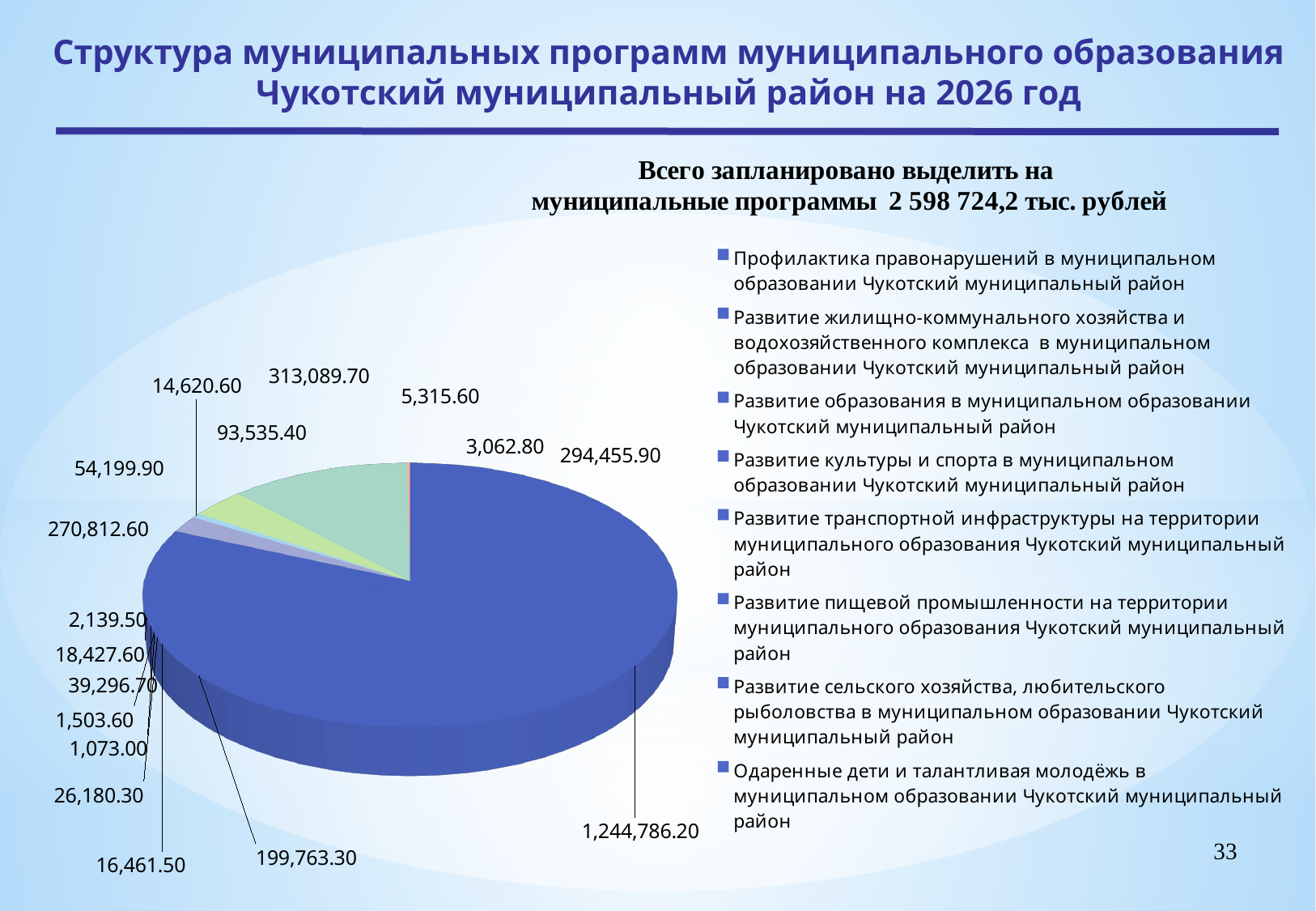
What is the second largest value labelled on the pie chart? 313,089.70 For which year does the slide title say the structure of municipal programmes is shown? 2026 What kind of chart is shown on the slide? pie chart What is the first entry listed in the chart legend? Профилактика правонарушений в муниципальном образовании Чукотский муниципальный район What is the difference between the labelled values 313,089.70 and 294,455.90? 18,633.80 What is the largest value labelled on the pie chart? 1,244,786.20 Which labelled value is larger: 294,455.90 or 270,812.60? 294,455.90 What is the smallest value labelled on the pie chart? 1,073.00 How many legend entries are visible on the slide? 8 How many value labels are shown around the pie chart? 17 What is the difference between the largest labelled value (1,244,786.20) and the second largest (313,089.70)? 931,696.50 According to the text above the chart, what total amount is planned for municipal programmes? 2 598 724,2 тыс. рублей